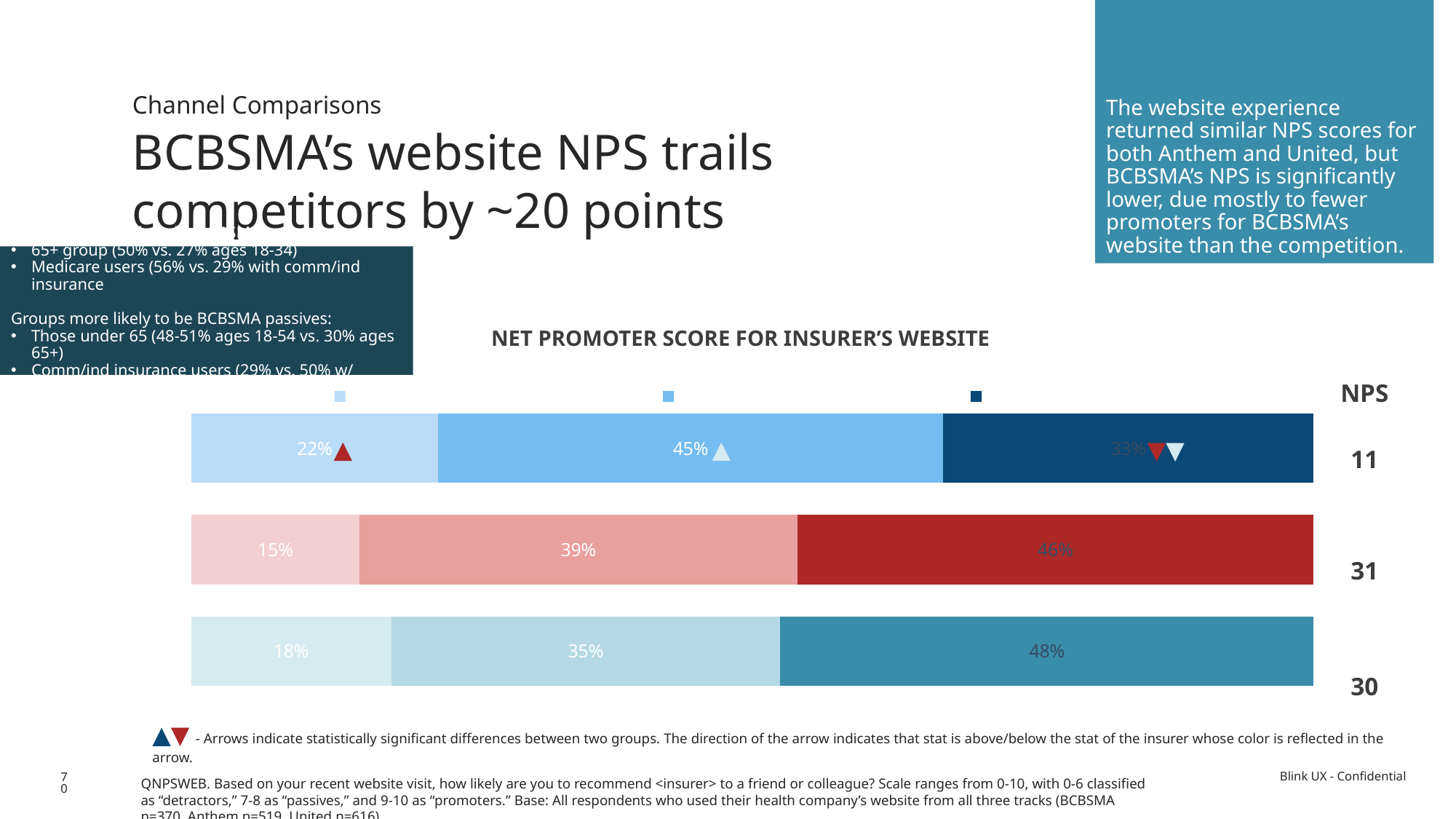
What is the value of the last (rightmost) segment of the bottom bar? 48% Which bar has the highest NPS value? the middle (red) bar What NPS value is shown for the top (blue) bar? 11 What is the value of the first (leftmost) segment of the top bar? 22% What is the value of the middle segment of the middle (red) bar? 39% What kind of chart is shown under the title 'NET PROMOTER SCORE FOR INSURER'S WEBSITE'? bar chart What is the title of the chart? NET PROMOTER SCORE FOR INSURER'S WEBSITE Which bar has the lowest NPS value? the top (blue) bar What is the difference between the NPS of the middle bar and the NPS of the top bar? 20 How many stacked bars does the chart contain? 3 Which is larger: the rightmost segment of the middle bar or the rightmost segment of the bottom bar? the bottom bar (48%) What NPS value is shown for the middle (red) bar? 31